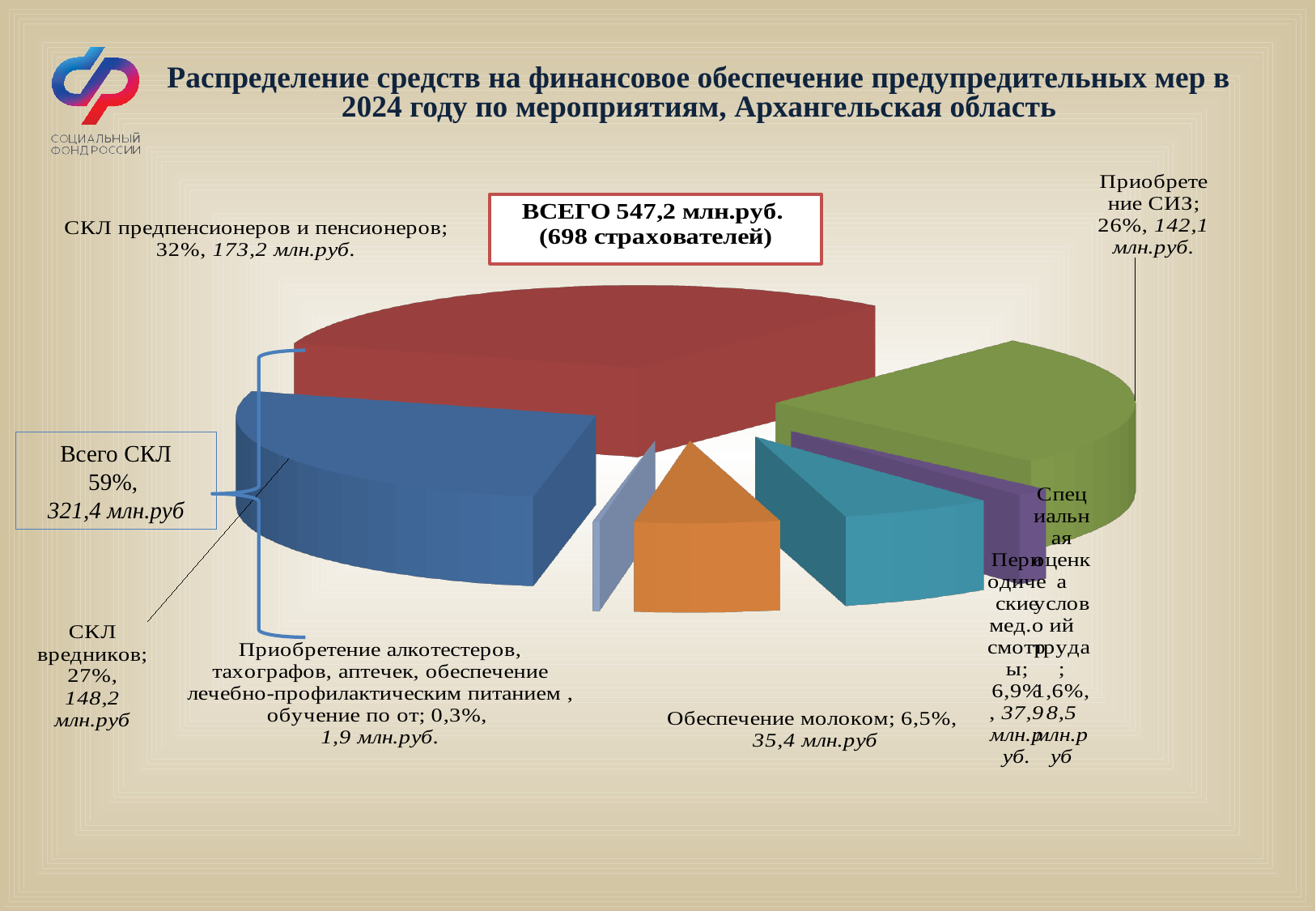
What share of the funds does «Всего СКЛ» account for? 59% What kind of chart is shown on the slide? pie chart What amount in млн.руб. is allocated to «Приобретение СИЗ»? 142,1 млн.руб. How many slices does the pie chart have? 7 Which is larger: the share for «СКЛ вредников» or for «Приобретение СИЗ»? СКЛ вредников What amount in млн.руб. is allocated to «СКЛ вредников»? 148,2 млн.руб What share of the funds goes to «СКЛ предпенсионеров и пенсионеров»? 32% What total amount (ВСЕГО) is shown in the box above the chart? 547,2 млн.руб. What share of the funds goes to «Обеспечение молоком»? 6,5% Which category has the largest share of the pie? СКЛ предпенсионеров и пенсионеров Which category has the smallest share of the pie? Приобретение алкотестеров, тахографов, аптечек, обеспечение лечебно-профилактическим питанием, обучение по от What is the difference in млн.руб. between «СКЛ предпенсионеров и пенсионеров» and «СКЛ вредников»? 25,0 млн.руб.